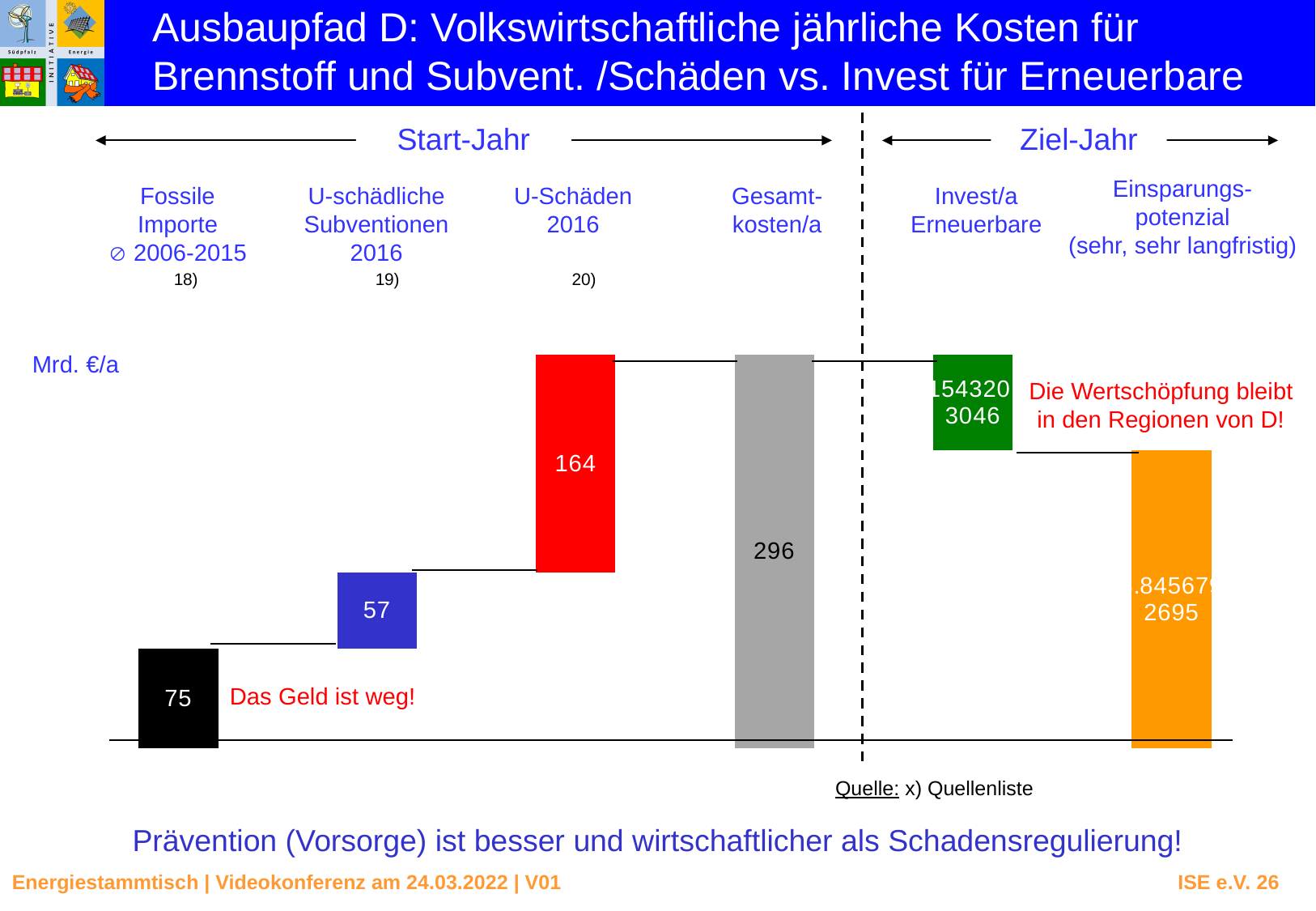
Which of the three Start-Jahr components (Fossile Importe, U-schädliche Subventionen, U-Schäden 2016) has the highest value? U-Schäden 2016 Which of the three Start-Jahr components (Fossile Importe, U-schädliche Subventionen, U-Schäden 2016) has the lowest value? U-schädliche Subventionen 2016 What is the value for U-schädliche Subventionen 2016? 57 What is the difference between the value for U-Schäden 2016 and the value for U-schädliche Subventionen 2016? 107 What unit is given for the values on the chart? Mrd. €/a Which is larger, the value for Fossile Importe or the value for U-schädliche Subventionen 2016? Fossile Importe What is the value for Fossile Importe (⌀ 2006-2015)? 75 What is the difference between the value for Fossile Importe and the value for U-schädliche Subventionen 2016? 18 What is the value for Gesamtkosten/a? 296 What is the value for U-Schäden 2016? 164 What kind of chart is shown on the slide? Bar chart (waterfall) What is the sum of the three Start-Jahr components Fossile Importe, U-schädliche Subventionen and U-Schäden 2016? 296